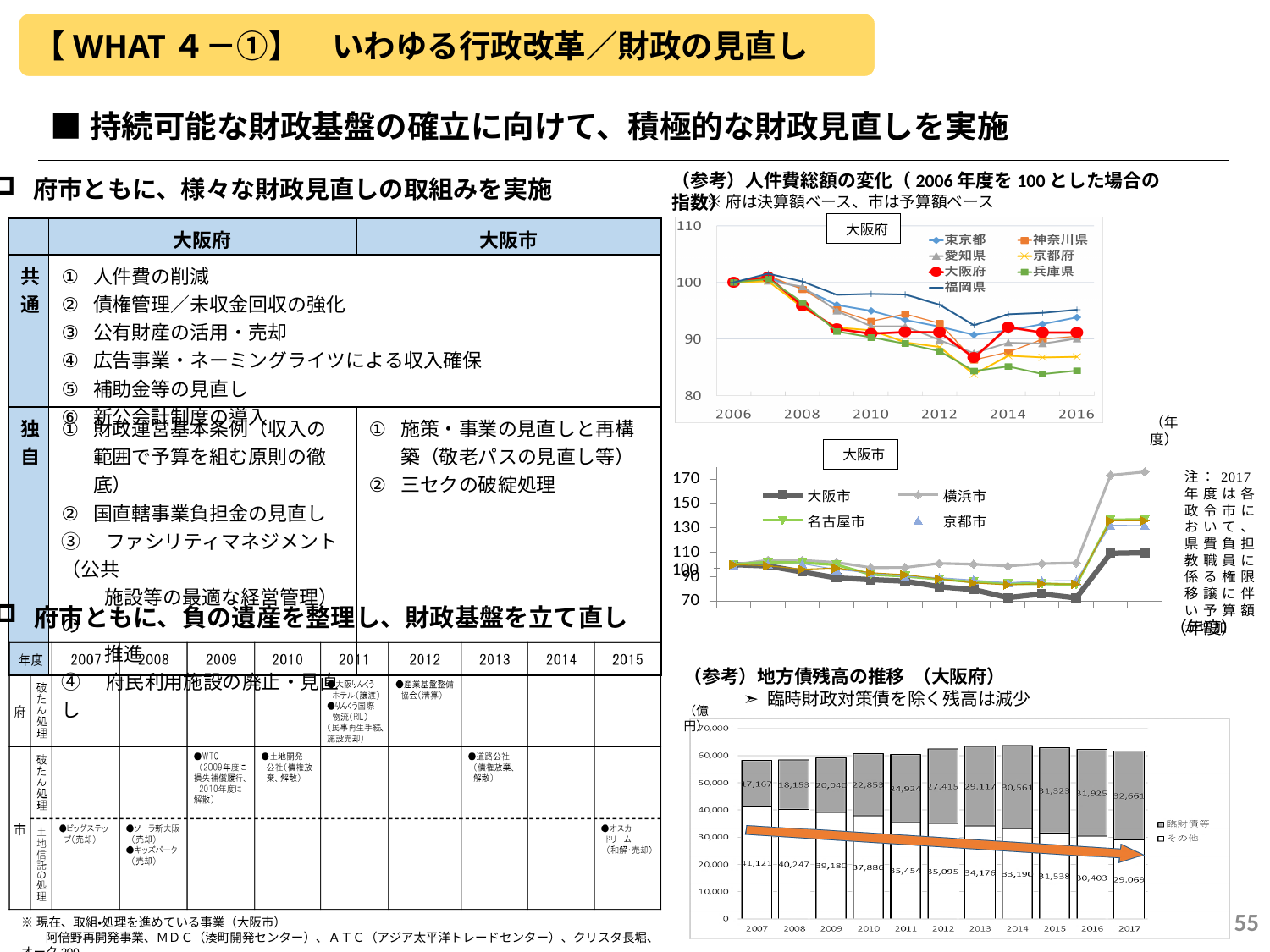
In the 地方債残高の推移（大阪府） chart, which year has the highest value for その他? 2007 In the 地方債残高の推移（大阪府） chart, what is the value of 臨財債等 in 2017? 32,661 What kind of chart is the 地方債残高の推移（大阪府） chart? bar chart How many years (bars) are shown in the 地方債残高の推移（大阪府） chart? 11 In the 地方債残高の推移（大阪府） chart, what is the difference between the その他 value in 2007 and in 2017? 12,052 In the 地方債残高の推移（大阪府） chart, which year has the lowest value for その他? 2017 How many series does the legend of the 大阪府 line chart (人件費総額の変化) list? 7 In the 地方債残高の推移（大阪府） chart, which is larger in 2017, 臨財債等 or その他? 臨財債等 In the 地方債残高の推移（大阪府） chart, what is the total of the stacked bar for 2007? 58,288 In the 大阪市 line chart, is the value for 横浜市 in 2017 greater or less than 150? greater In the 地方債残高の推移（大阪府） chart, what is the value of その他 in 2007? 41,121 In the 地方債残高の推移（大阪府） chart, does the その他 series rise or fall from 2007 to 2017? fall